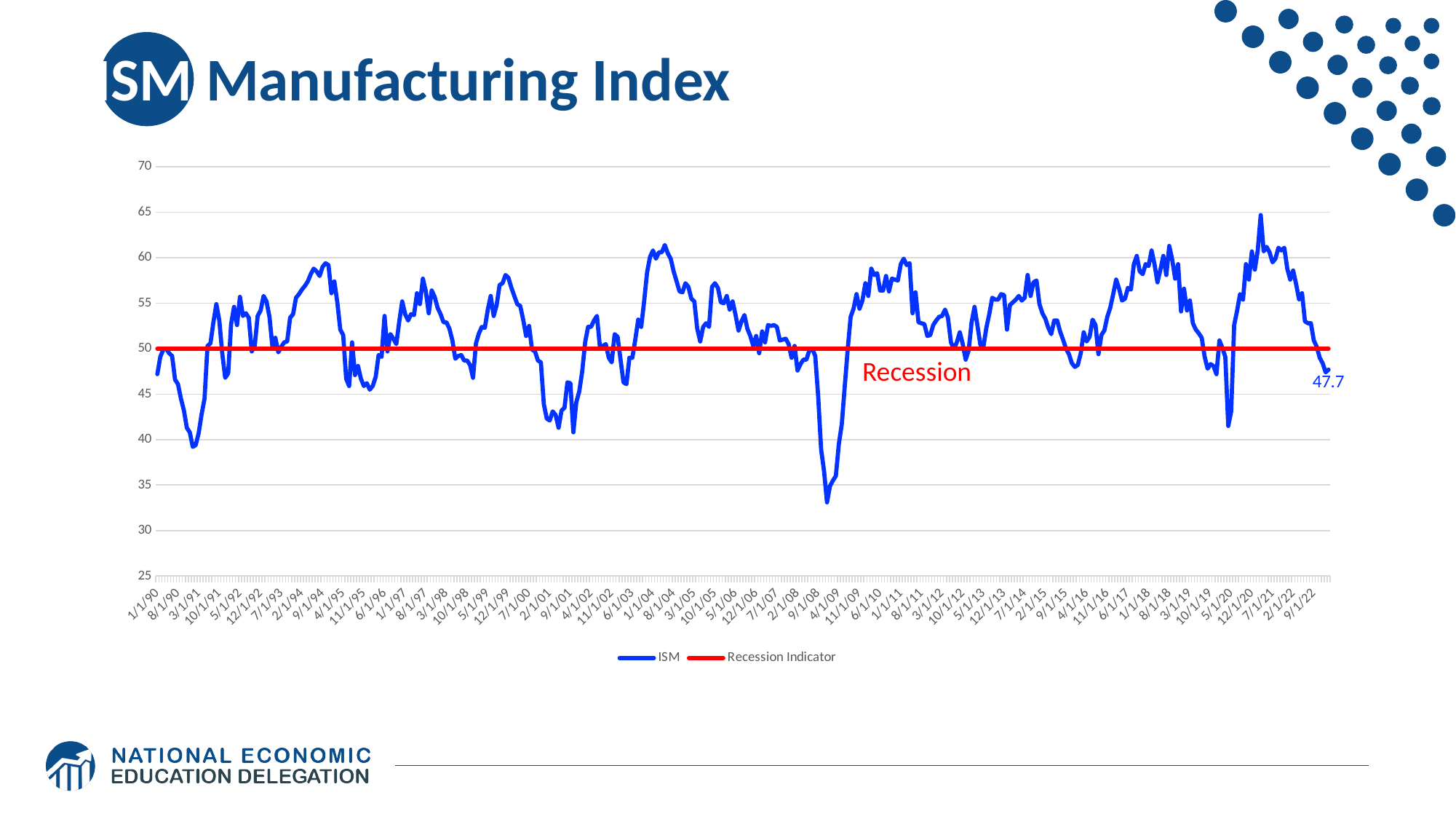
Is the ISM value at its lowest point around early 2009 greater or less than 35? less In which year does the ISM line reach its highest point? 2021 What kind of chart is shown on the slide? line chart Is the ISM value at the dip around 5/1/20 greater or less than 45? less Around which period does the ISM line reach its lowest point? late 2008 What label is written in red next to the horizontal red line? Recession At what value on the y axis is the Recession Indicator line drawn? 50 What is the title of the chart? ISM Manufacturing Index How many series does the legend list? 2 What is the last data label shown on the ISM line? 47.7 Is the ISM value at its peak in 2021 greater or less than 60? greater Is the final ISM value of 47.7 above or below the Recession Indicator line? below